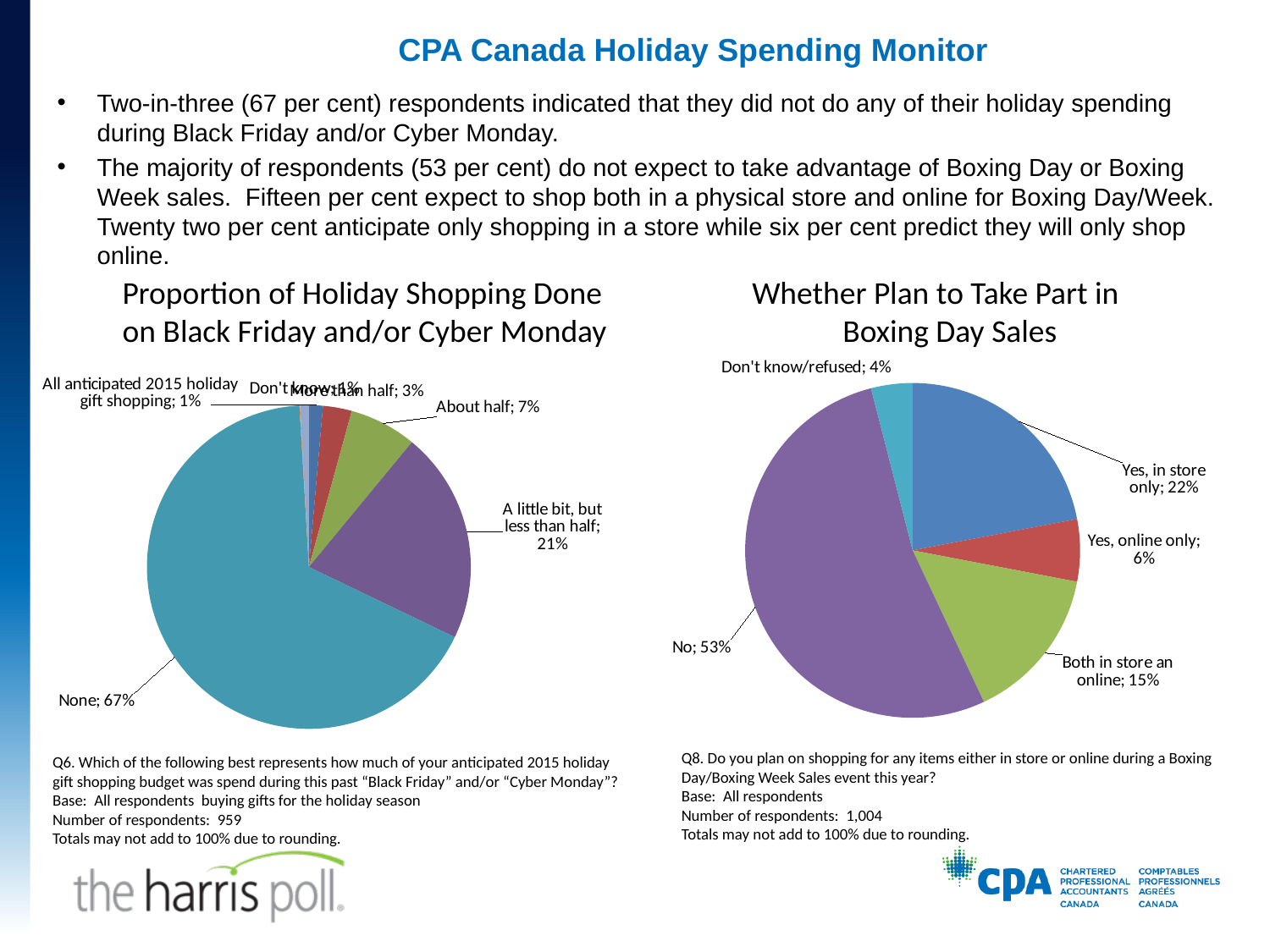
In the 'Proportion of Holiday Shopping Done on Black Friday and/or Cyber Monday' chart, what is the difference between 'About half' and 'More than half'? 4% In the 'Whether Plan to Take Part in Boxing Day Sales' chart, which is larger: 'Both in store an online' or 'Yes, online only'? Both in store an online How many categories are shown in the 'Whether Plan to Take Part in Boxing Day Sales' chart? 5 In the 'Proportion of Holiday Shopping Done on Black Friday and/or Cyber Monday' chart, what is the value for 'None'? 67% In the 'Whether Plan to Take Part in Boxing Day Sales' chart, which category has the smallest slice? Don't know/refused In the 'Whether Plan to Take Part in Boxing Day Sales' chart, what is the value for 'Yes, in store only'? 22% In the 'Whether Plan to Take Part in Boxing Day Sales' chart, what is the difference between 'Yes, in store only' and 'Yes, online only'? 16% In the 'Proportion of Holiday Shopping Done on Black Friday and/or Cyber Monday' chart, what is the value for 'A little bit, but less than half'? 21% In the 'Proportion of Holiday Shopping Done on Black Friday and/or Cyber Monday' chart, which category has the largest slice? None In the 'Whether Plan to Take Part in Boxing Day Sales' chart, what share of respondents answered 'No'? 53% In the 'Whether Plan to Take Part in Boxing Day Sales' chart, which category has the largest slice? No What type of chart is used for 'Whether Plan to Take Part in Boxing Day Sales'? Pie chart